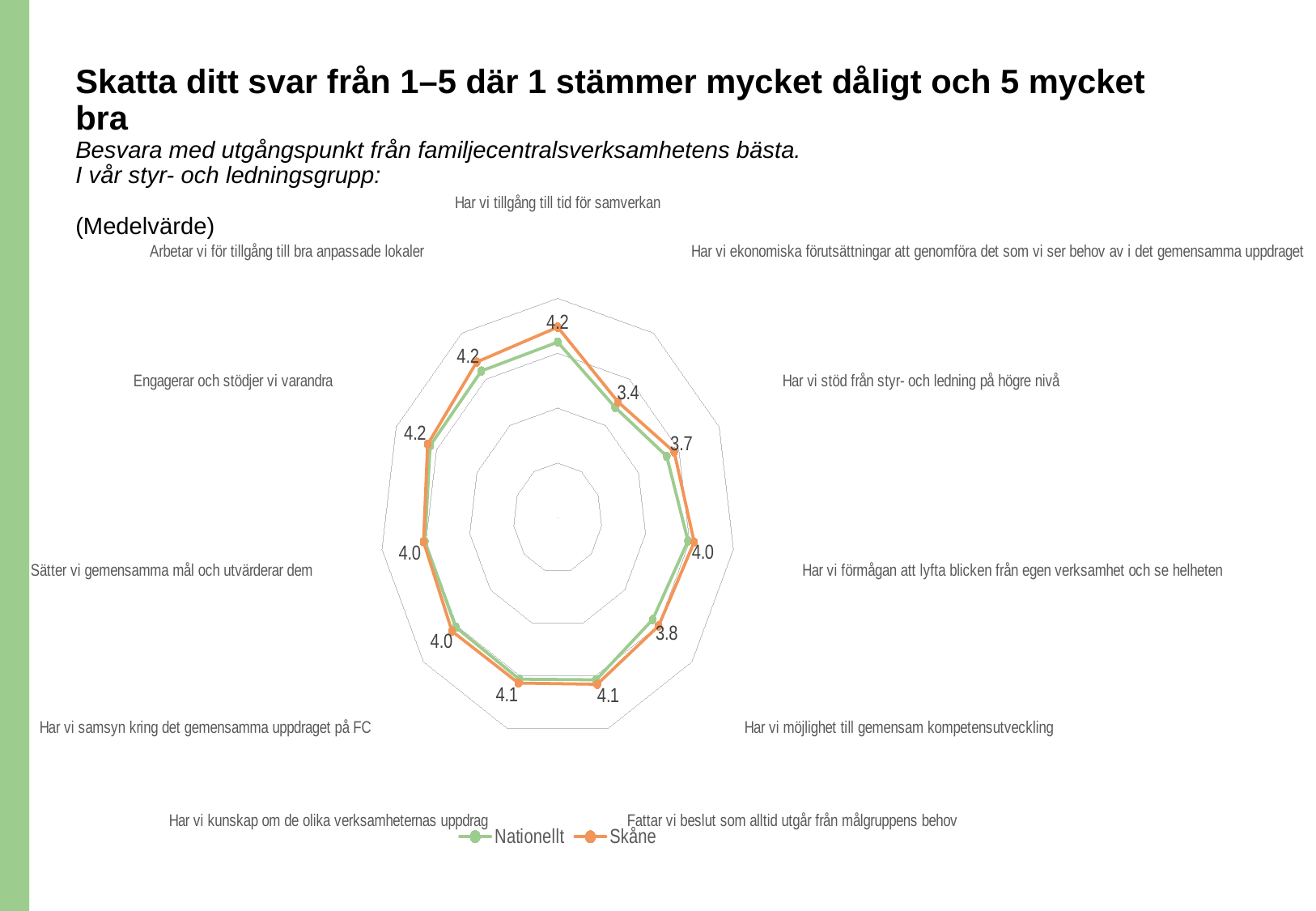
What is the labelled value for 'Har vi tillgång till tid för samverkan'? 4.2 What is the labelled value for 'Har vi möjlighet till gemensam kompetensutveckling'? 3.8 What is the difference between the labelled values for 'Har vi tillgång till tid för samverkan' and 'Har vi ekonomiska förutsättningar att genomföra det som vi ser behov av i det gemensamma uppdraget'? 0.8 How many series does the legend list? 2 What is the labelled value for 'Har vi ekonomiska förutsättningar att genomföra det som vi ser behov av i det gemensamma uppdraget'? 3.4 How many categories (axes) does the radar chart have? 11 What is the labelled value for 'Har vi stöd från styr- och ledning på högre nivå'? 3.7 What kind of chart is shown on the slide? Radar chart What are the two series named in the legend? Nationellt and Skåne Which has the larger labelled value: 'Har vi stöd från styr- och ledning på högre nivå' or 'Har vi ekonomiska förutsättningar att genomföra det som vi ser behov av i det gemensamma uppdraget'? Har vi stöd från styr- och ledning på högre nivå What is the labelled value for 'Fattar vi beslut som alltid utgår från målgruppens behov'? 4.1 Which category has the lowest labelled value? Har vi ekonomiska förutsättningar att genomföra det som vi ser behov av i det gemensamma uppdraget